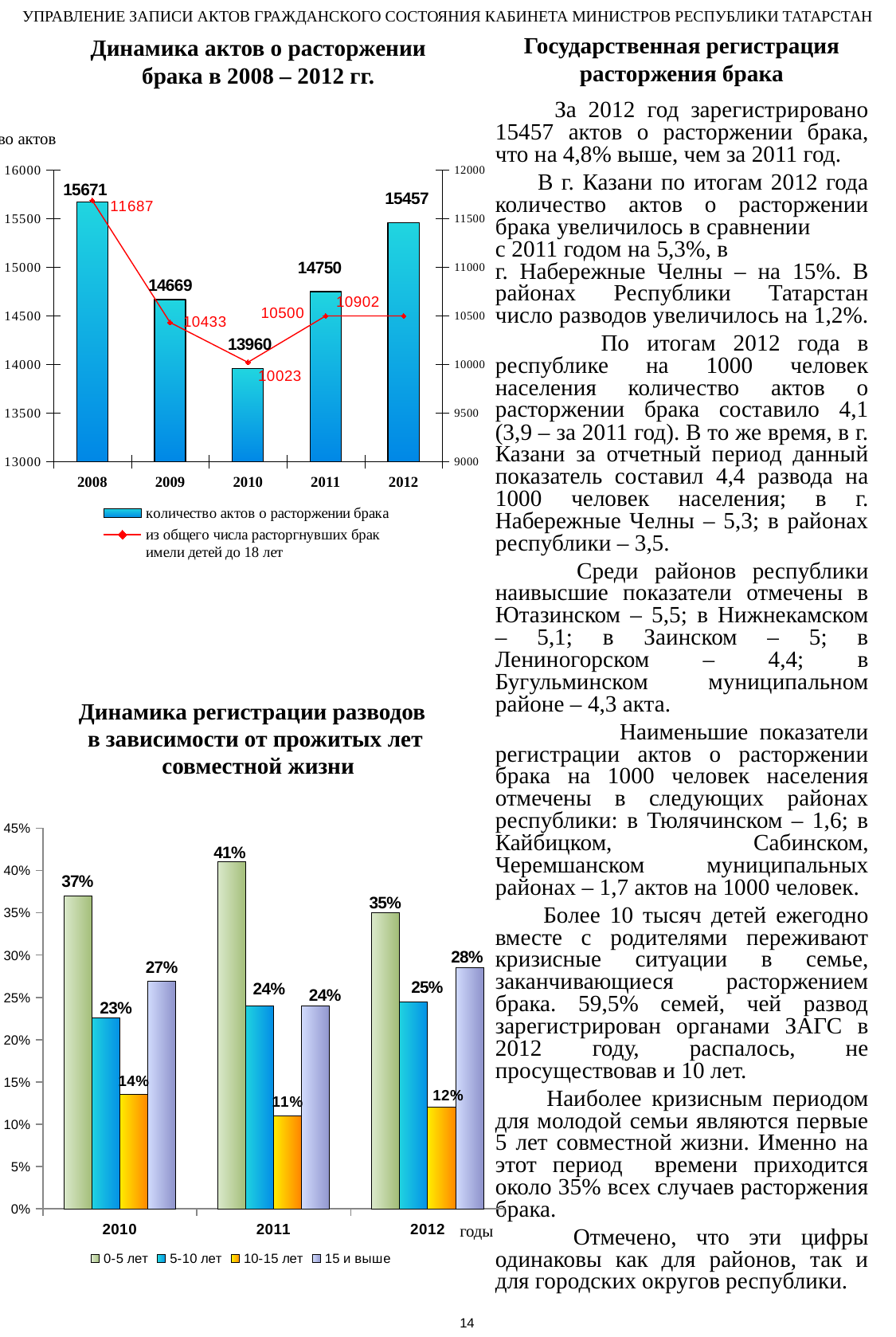
In the chart 'Динамика актов о расторжении брака в 2008 – 2012 гг.', how many years are shown on the x axis? 5 In the chart 'Динамика актов о расторжении брака в 2008 – 2012 гг.', which year has the highest number of divorce acts? 2008 What kind of chart is 'Динамика регистрации разводов в зависимости от прожитых лет совместной жизни'? bar chart In the chart 'Динамика актов о расторжении брака в 2008 – 2012 гг.', how many series does the legend list? 2 In the chart 'Динамика регистрации разводов в зависимости от прожитых лет совместной жизни', how many series does the legend list? 4 In the chart 'Динамика регистрации разводов в зависимости от прожитых лет совместной жизни', what is the share for '0-5 лет' in 2011? 41% In the chart 'Динамика регистрации разводов в зависимости от прожитых лет совместной жизни', which category has the lowest value in 2011? 10-15 лет In the chart 'Динамика актов о расторжении брака в 2008 – 2012 гг.', what is the number of divorce acts (количество актов о расторжении брака) in 2010? 13960 In the chart 'Динамика регистрации разводов в зависимости от прожитых лет совместной жизни', which is larger in 2012: '5-10 лет' or '15 и выше'? 15 и выше In the chart 'Динамика актов о расторжении брака в 2008 – 2012 гг.', which year has the lowest value on the line for divorces with children under 18? 2010 In the chart 'Динамика актов о расторжении брака в 2008 – 2012 гг.', what is the value of the line (divorces with children under 18) in 2009? 10433 In the chart 'Динамика актов о расторжении брака в 2008 – 2012 гг.', what is the difference between the number of divorce acts in 2012 and in 2011? 707